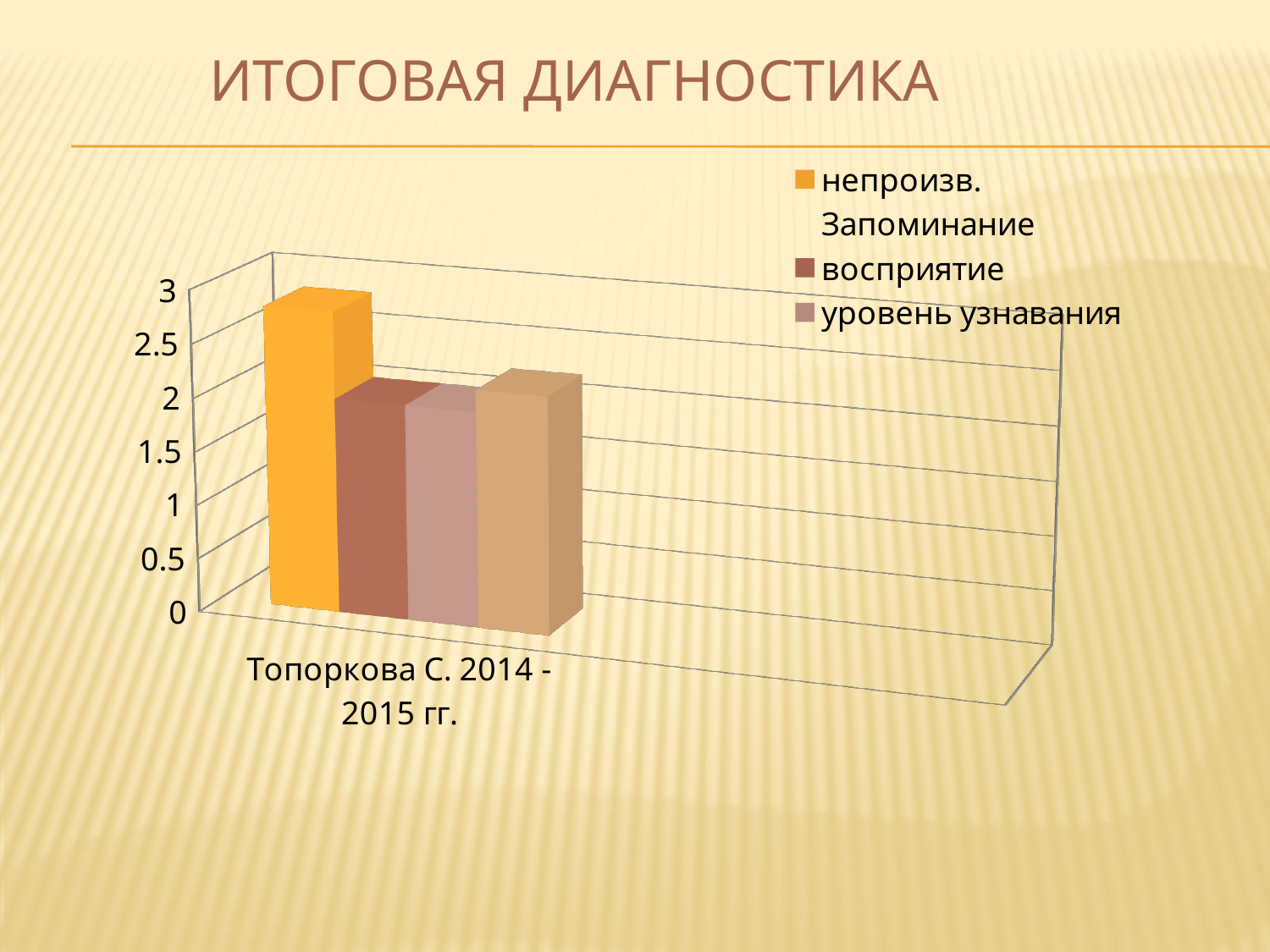
What is the highest value shown on the vertical axis of the chart? 3 What kind of chart is shown on the slide? bar chart How many categories are shown on the x axis of the chart? 1 Which series has the highest bar for Топоркова С. 2014 - 2015 гг.? непроизв. Запоминание What is the category label shown on the x axis of the chart? Топоркова С. 2014 - 2015 гг. Which is larger, the bar for непроизв. Запоминание or the bar for восприятие? непроизв. Запоминание What is the title of the slide containing the chart? ИТОГОВАЯ ДИАГНОСТИКА Is the value for непроизв. Запоминание greater or less than 2? greater Is the value for восприятие greater or less than 3? less Is the value for уровень узнавания greater or less than 1? greater How many series does the chart legend list? 3